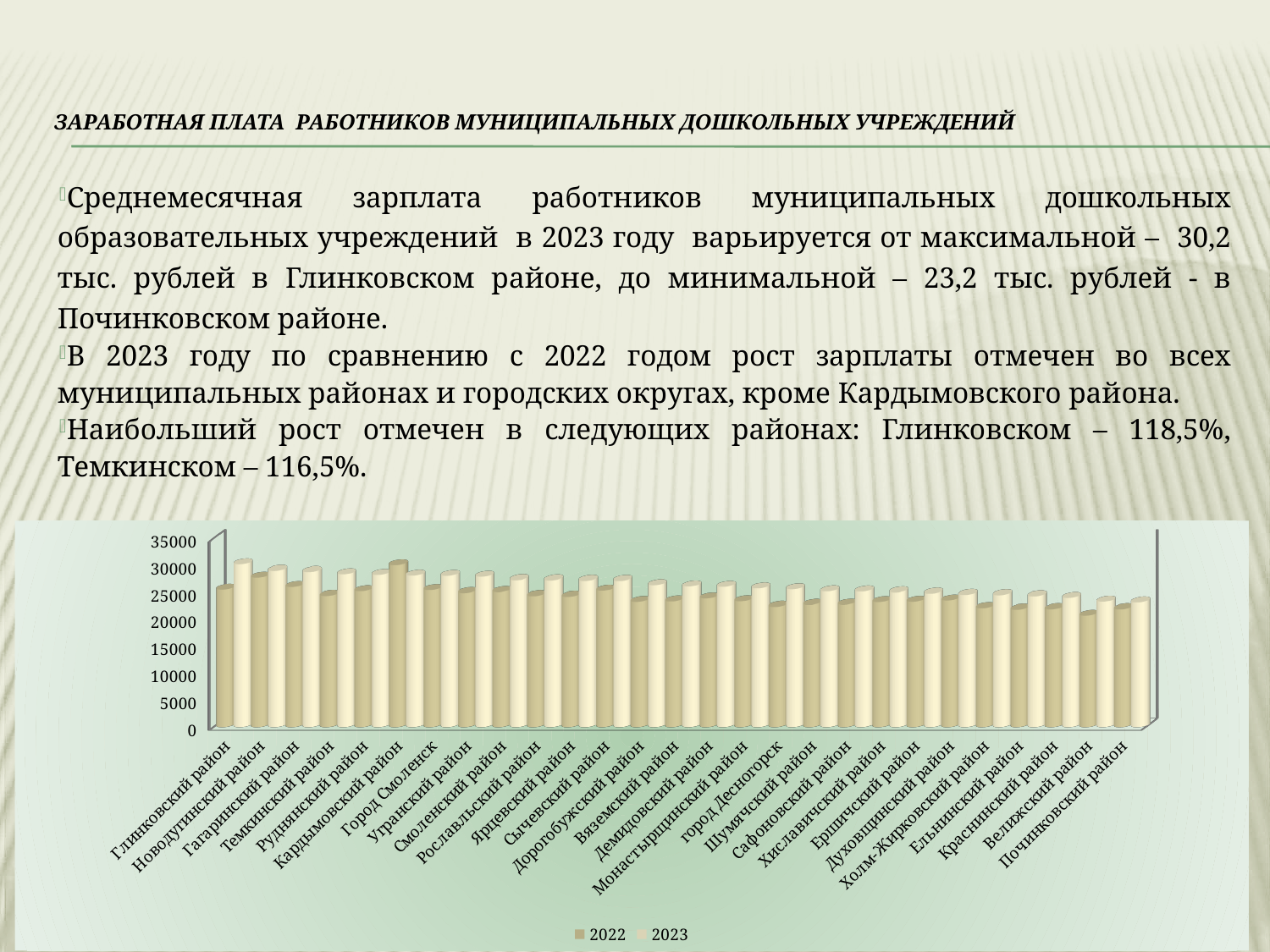
Do the 2023 values rise or fall moving from left to right along the x axis? fall For Глинковский район, which is larger: the 2022 value or the 2023 value? 2023 Is the 2023 value for Город Смоленск greater or less than 25000? greater Is the 2023 value for Починковский район greater or less than 25000? less How many districts (categories) are shown on the x axis of the chart? 27 Which is larger: the 2023 value for Глинковский район or the 2023 value for Починковский район? Глинковский район What are the two series named in the chart legend? 2022 and 2023 Which district has the lowest 2023 value in the chart? Починковский район Which district has the highest 2023 value in the chart? Глинковский район What kind of chart is shown on the slide? bar chart How many series does the chart legend list? 2 Is the 2022 value for Велижский район greater or less than 25000? less